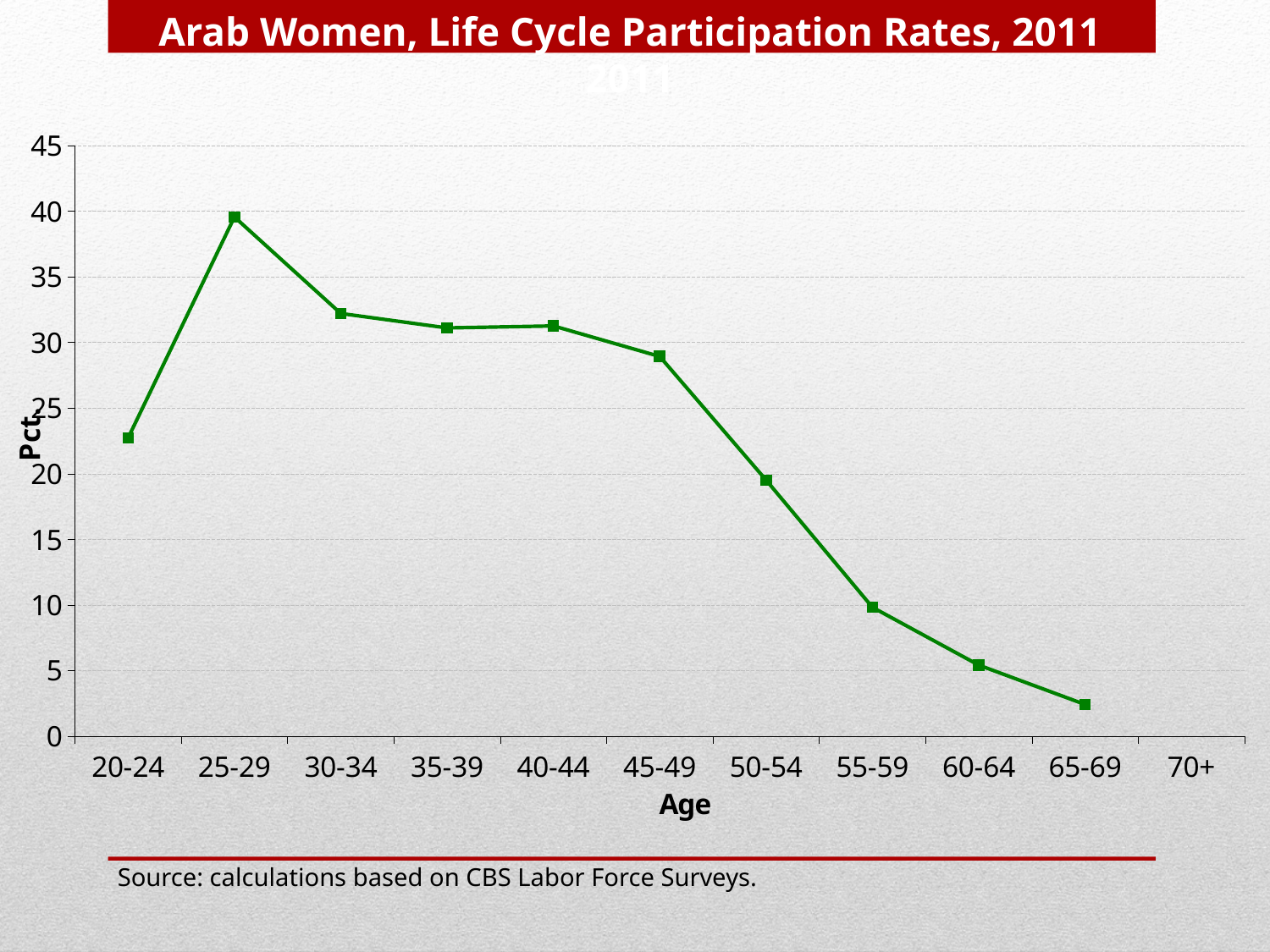
Which age group has the lowest plotted participation rate? 65-69 What is the label of the x axis? Age Do the values rise or fall from 45-49 to 65-69? fall How many age groups are labeled on the x axis? 11 Which has a higher participation rate, 20-24 or 45-49? 45-49 Is the value for 65-69 greater or less than 5? less Is the value for 20-24 greater or less than 25? less Is the value for 25-29 greater or less than 35? greater Which age group has the highest participation rate? 25-29 What kind of chart is shown on the slide? line chart What is the title of the chart? Arab Women, Life Cycle Participation Rates, 2011